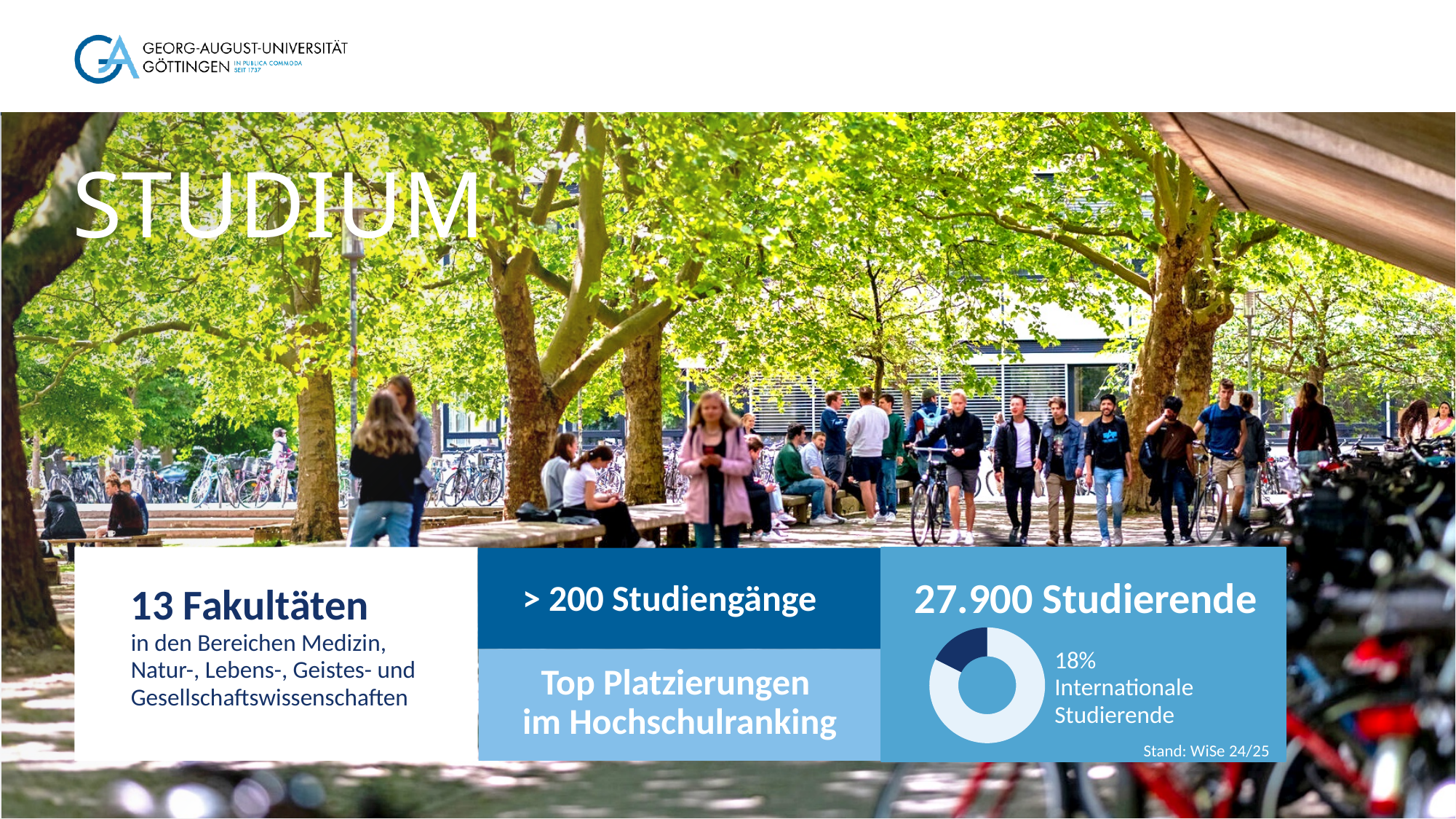
What share of students does the donut chart show as international students (Internationale Studierende)? 18% What does the dark blue slice of the donut chart represent? Internationale Studierende Which slice of the donut chart is larger: the international students slice or the remaining students slice? The remaining students slice What date/semester is given as the status ('Stand') for the donut chart data? WiSe 24/25 Is the share of international students shown in the donut chart greater or less than 20%? less How many slices does the donut chart have? 2 What total number of students is stated above the donut chart? 27.900 Studierende What kind of chart is shown in the '27.900 Studierende' box? Pie (donut) chart